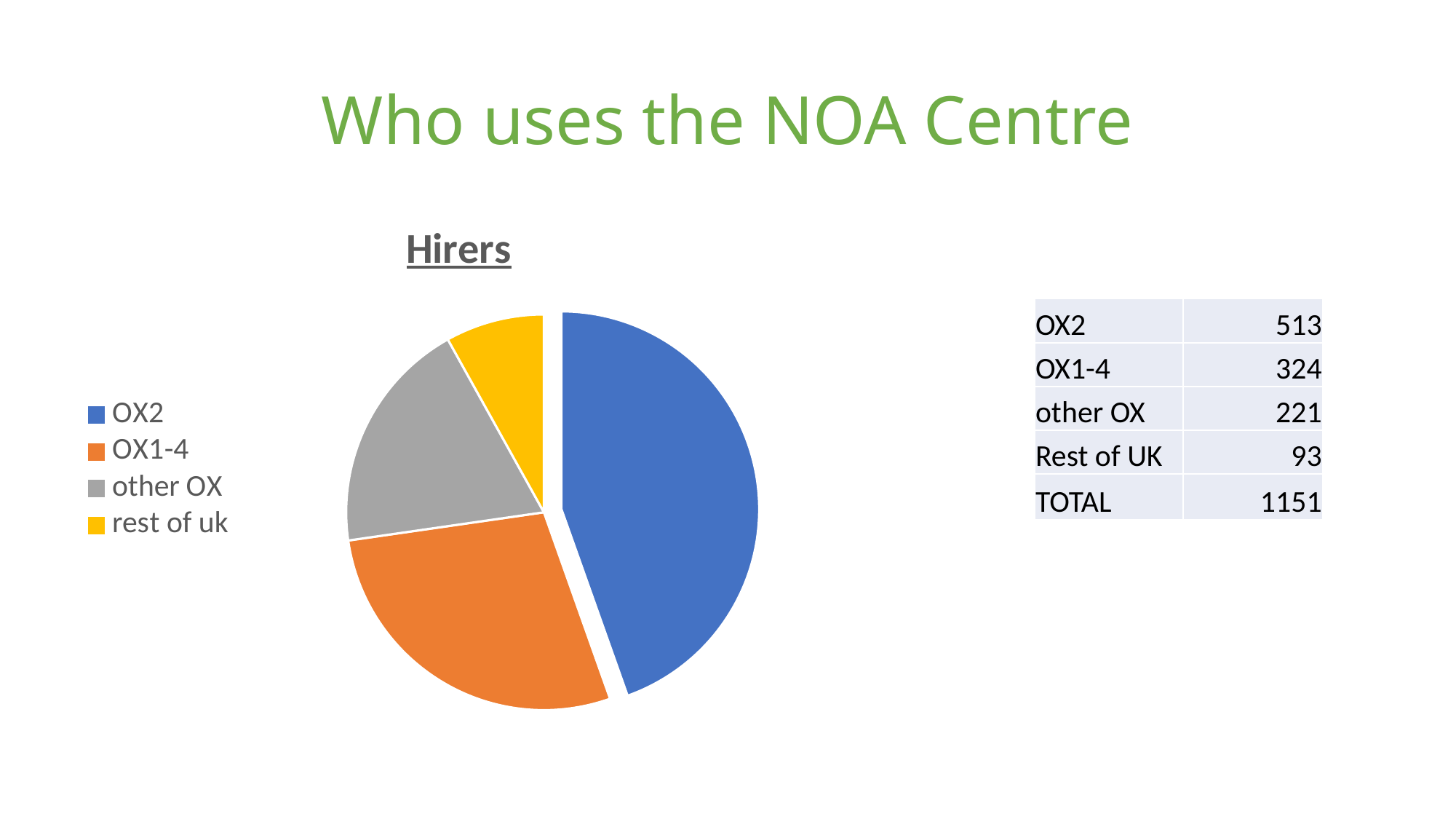
What is the value for other OX? 221 What is the value for OX2? 513 What is the value for Rest of UK? 93 How many slices does the pie chart have? 4 What is the total of all the categories shown? 1151 Which is larger, the value for OX1-4 or the value for other OX? OX1-4 What is the difference between the values for OX2 and OX1-4? 189 Which category has the smallest slice of the pie? rest of uk What is the title of the chart? Hirers Which category has the largest slice of the pie? OX2 What kind of chart is shown on the slide? pie chart What is the value for OX1-4? 324